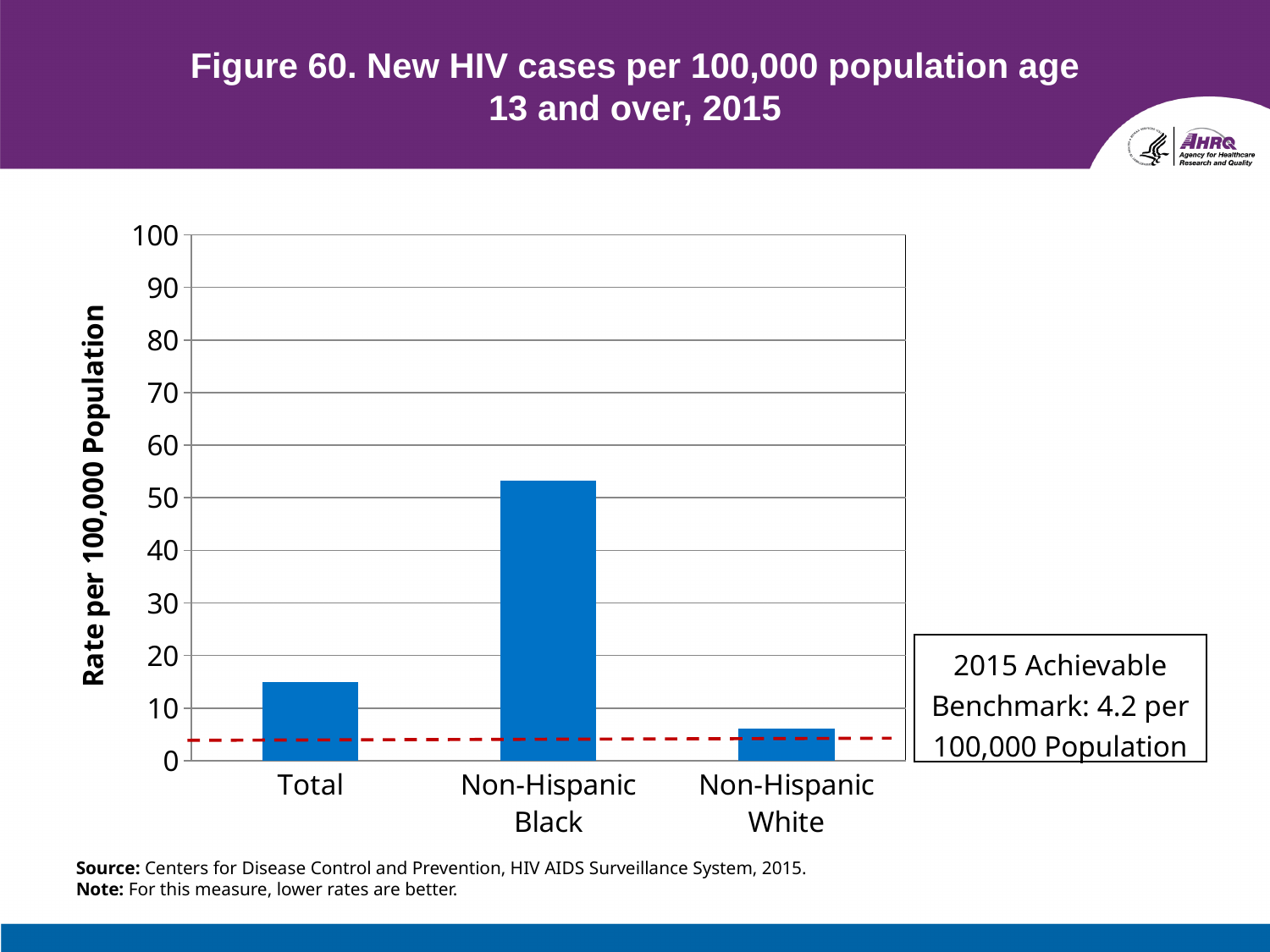
Which category has the highest rate of new HIV cases per 100,000 population? Non-Hispanic Black How many categories are shown on the x axis of the chart? 3 Which is larger, the rate for Total or the rate for Non-Hispanic White? Total Which category has the lowest rate of new HIV cases per 100,000 population? Non-Hispanic White Is the value for Non-Hispanic Black greater or less than 60? less Is the value for Non-Hispanic Black greater or less than 50? greater What is the title of the chart? Figure 60. New HIV cases per 100,000 population age 13 and over, 2015 Is the value for Non-Hispanic White greater or less than 10? less What is the label of the y axis? Rate per 100,000 Population What kind of chart is shown on the slide? bar chart What is the 2015 achievable benchmark shown on the chart? 4.2 per 100,000 Population